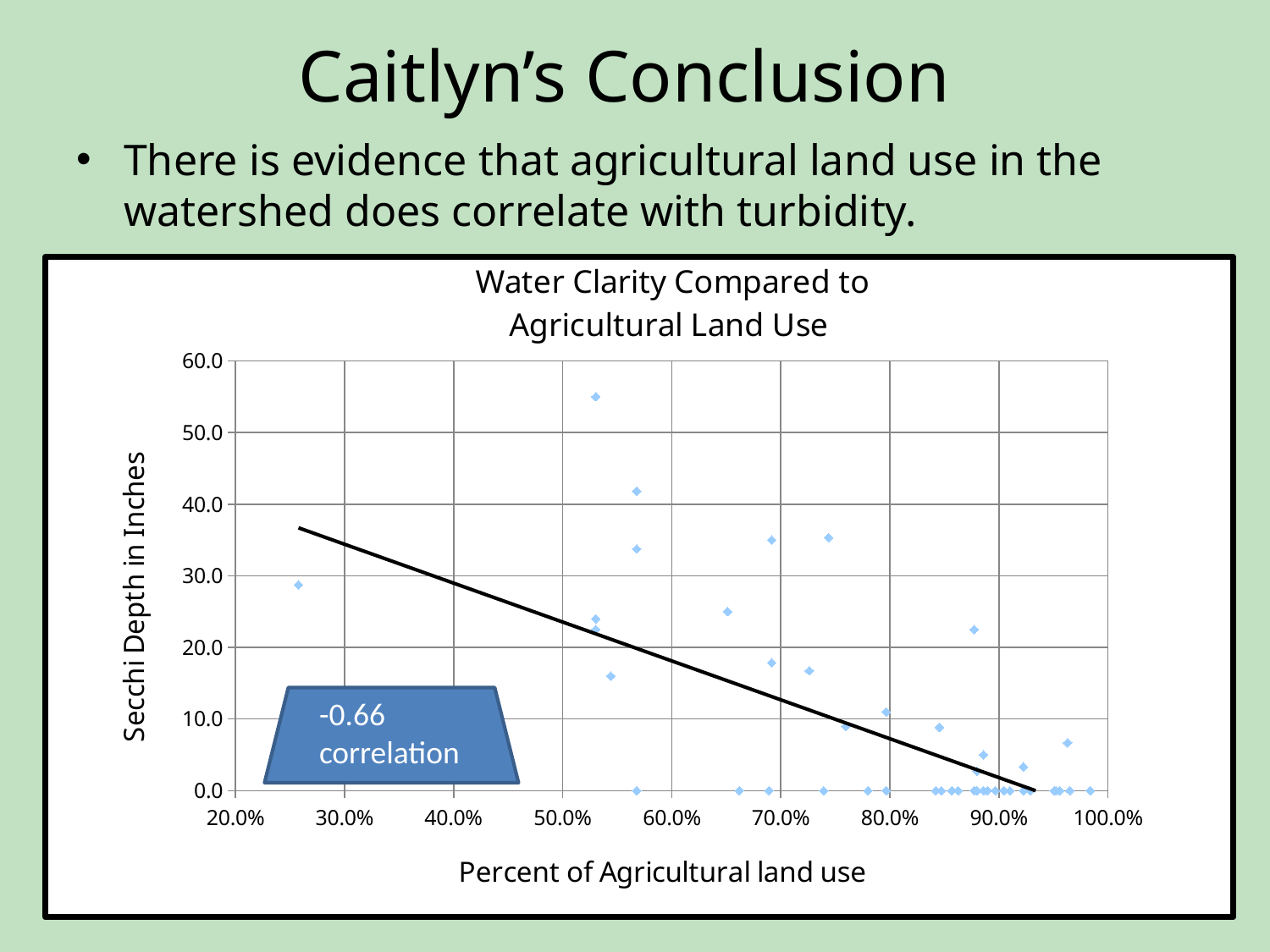
Is the Secchi depth for the point at roughly 74% agricultural land use that lies above the trend line greater or less than 30? greater Is the highest Secchi depth value plotted on the chart greater or less than 50? greater What Secchi depth value do the many points lying on the x axis near 90% agricultural land use share? 0.0 What is the title of the chart? Water Clarity Compared to Agricultural Land Use What correlation value is shown in the callout on the chart? -0.66 correlation Is the Secchi depth for the point at roughly 26% agricultural land use greater or less than 20? greater As the percent of agricultural land use increases, does the trend line for Secchi depth rise or fall? fall Which has the higher Secchi depth: the point at roughly 53% agricultural land use near the top of the chart, or the point at roughly 26% agricultural land use? the point at roughly 53% What kind of chart is shown on the slide? scatter chart